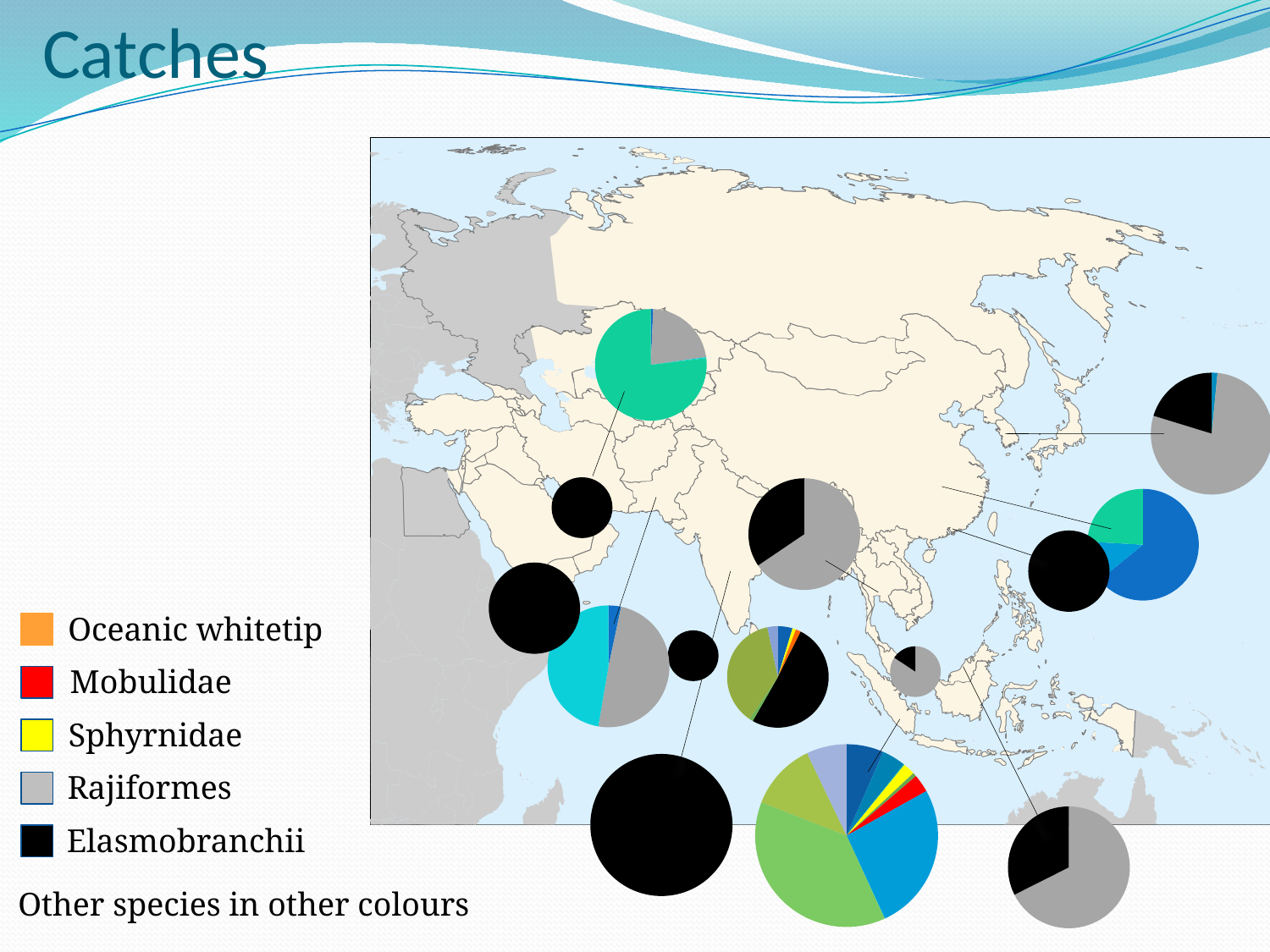
How many species groups are listed in the legend? 5 In the pie chart over the Philippines (right side of the map), which colour slice is the largest? Dark blue In the small pie chart over Malaysia, which slice is larger: Rajiformes or Elasmobranchii? Rajiformes Which species group is shown in black in the legend? Elasmobranchii In the pie chart over Central Asia (top left of the map), which is larger: the green slice or the grey Rajiformes slice? Green In the pie chart over Iran, which species group makes up the whole pie? Elasmobranchii What kind of chart is used on the map to show catches at each location? Pie chart In the pie chart at the bottom right of the map (over Indonesia), which slice is larger: Rajiformes or Elasmobranchii? Rajiformes Which colour represents Rajiformes in the legend? Grey In the large pie chart at the bottom centre of the map, which colour slice is the largest? Green